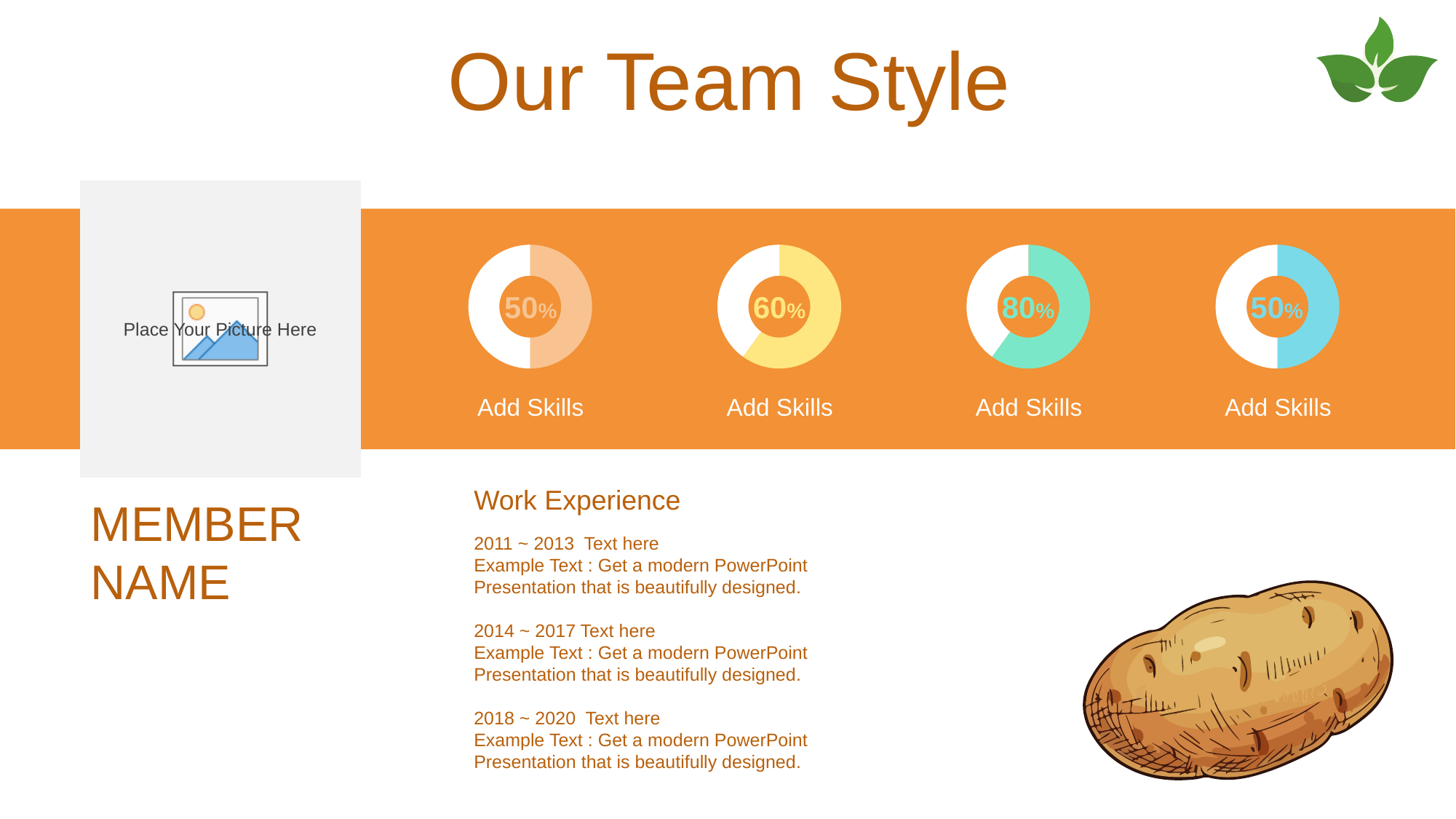
What kind of chart is used to display each skill percentage on the slide? Donut chart Which is larger: the value in the second donut chart or the value in the leftmost donut chart? The second donut chart (60%) What colour is the filled portion of the third donut chart from the left? Teal (green) What is the difference between the percentage in the third donut chart and the percentage in the second donut chart? 20% How many donut charts are shown on the orange band of the slide? 4 What value is shown in the centre of the rightmost donut chart? 50% What value is shown in the centre of the third donut chart from the left? 80% What value is shown in the centre of the second donut chart from the left? 60% Is the value in the third donut chart greater or less than 50%? greater What value is shown in the centre of the leftmost donut chart on the orange band? 50% What label appears beneath each of the four donut charts? Add Skills Which of the four donut charts shows the highest percentage? The third from the left (80%)